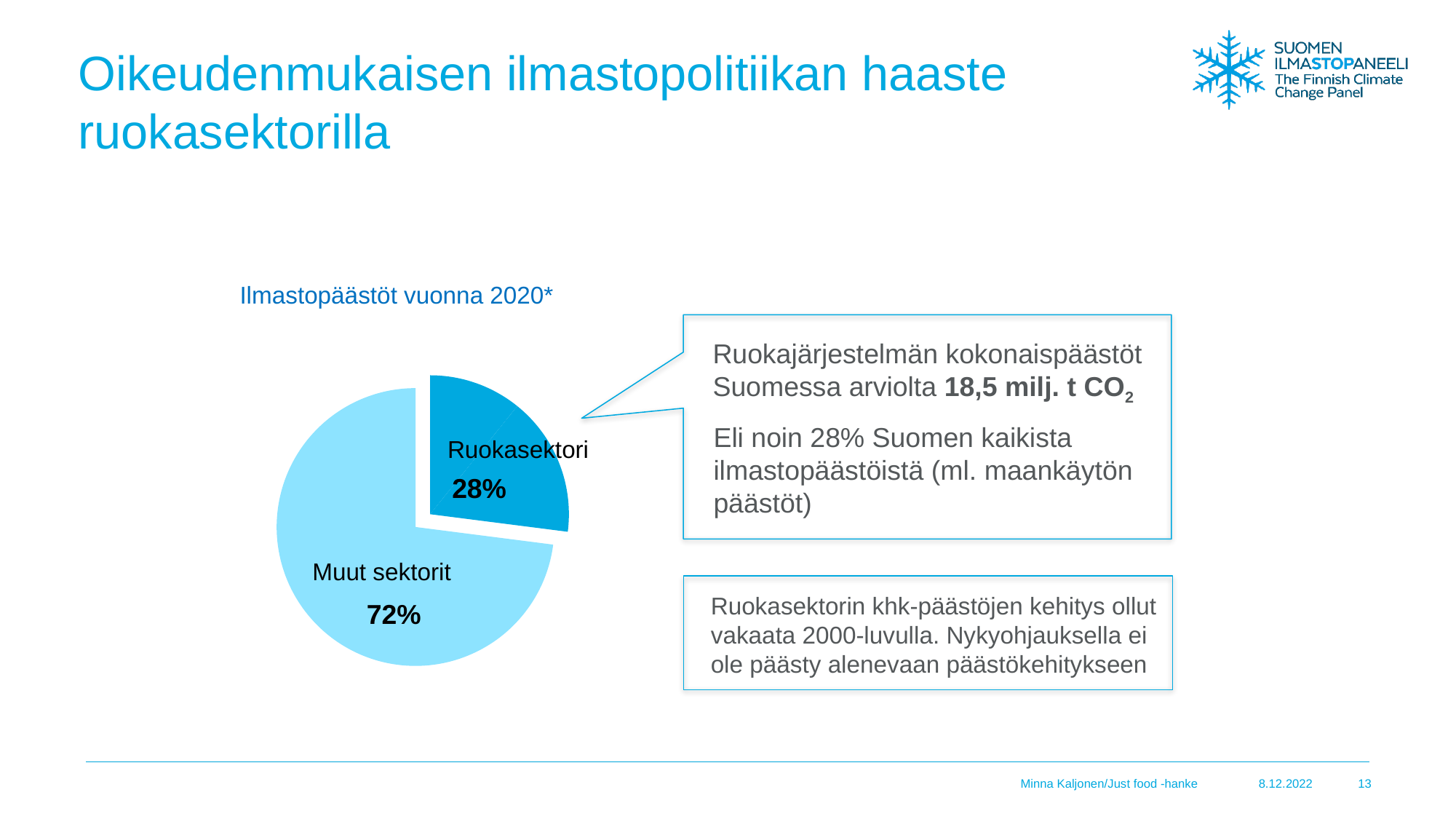
Which slice of the pie is the smallest? Ruokasektori What share of the pie does Ruokasektori represent? 28% What is the title of the chart? Ilmastopäästöt vuonna 2020* What share of the pie does Muut sektorit represent? 72% Which slice of the pie is pulled out (exploded) from the rest? Ruokasektori Which is larger, the share for Ruokasektori or the share for Muut sektorit? Muut sektorit Which slice of the pie is the largest? Muut sektorit What is the difference in percentage points between Muut sektorit and Ruokasektori? 44 What kind of chart is shown on the slide? pie chart Is the share for Ruokasektori greater or less than 50%? less How many slices does the pie chart have? 2